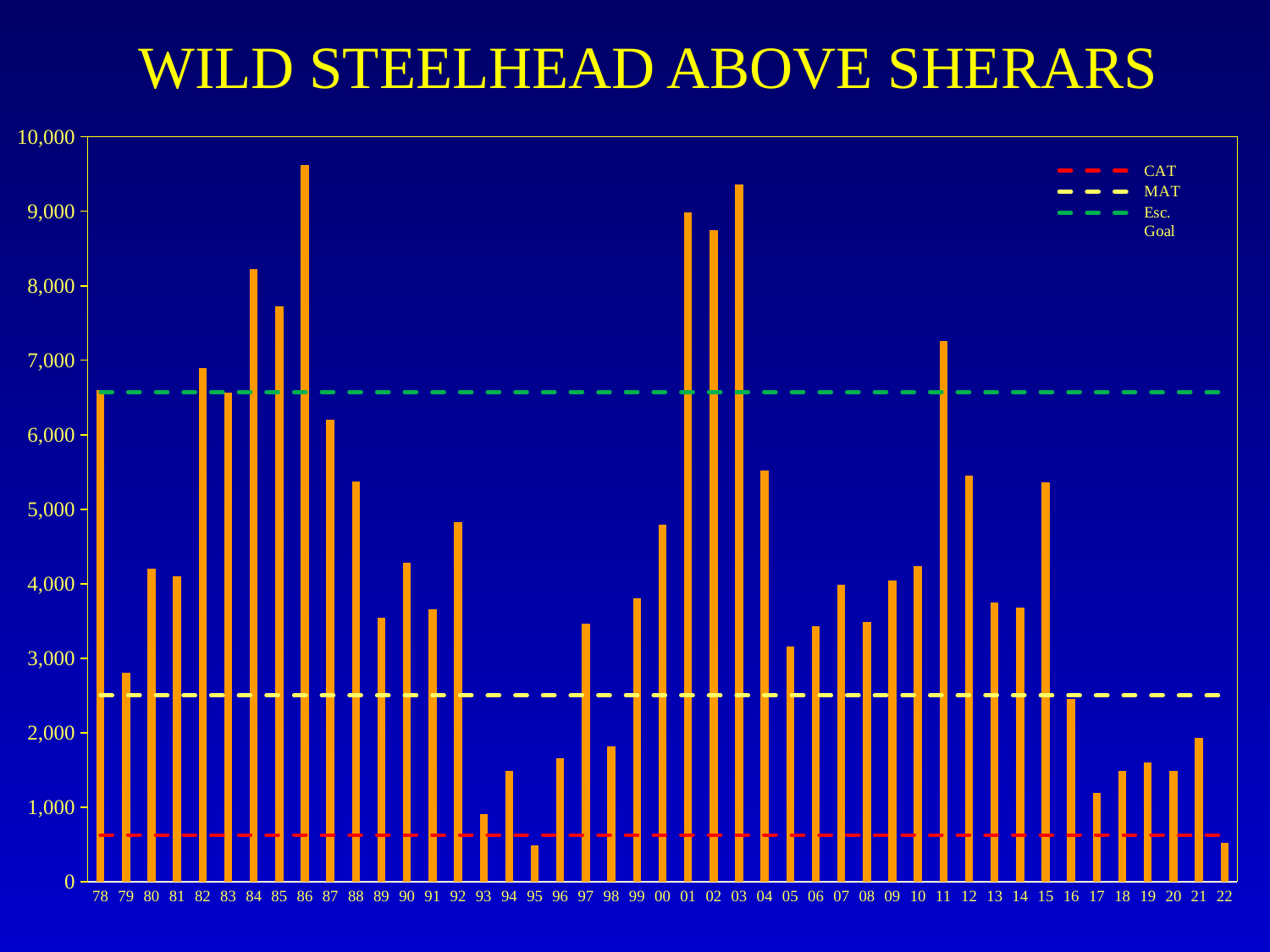
How many entries does the legend list? 3 What colour is the dashed line for Esc. Goal in the legend? green Is the value for 11 greater or less than 7,000? greater What is the title of the chart? WILD STEELHEAD ABOVE SHERARS Is the value for 86 greater or less than 9,000? greater Which year has the highest bar? 86 How many years are shown along the x axis? 45 What kind of chart is shown on the slide? bar chart Which is larger, the value for 84 or the value for 85? 84 Is the value for 92 greater or less than 5,000? less Which is larger, the value for 02 or the value for 03? 03